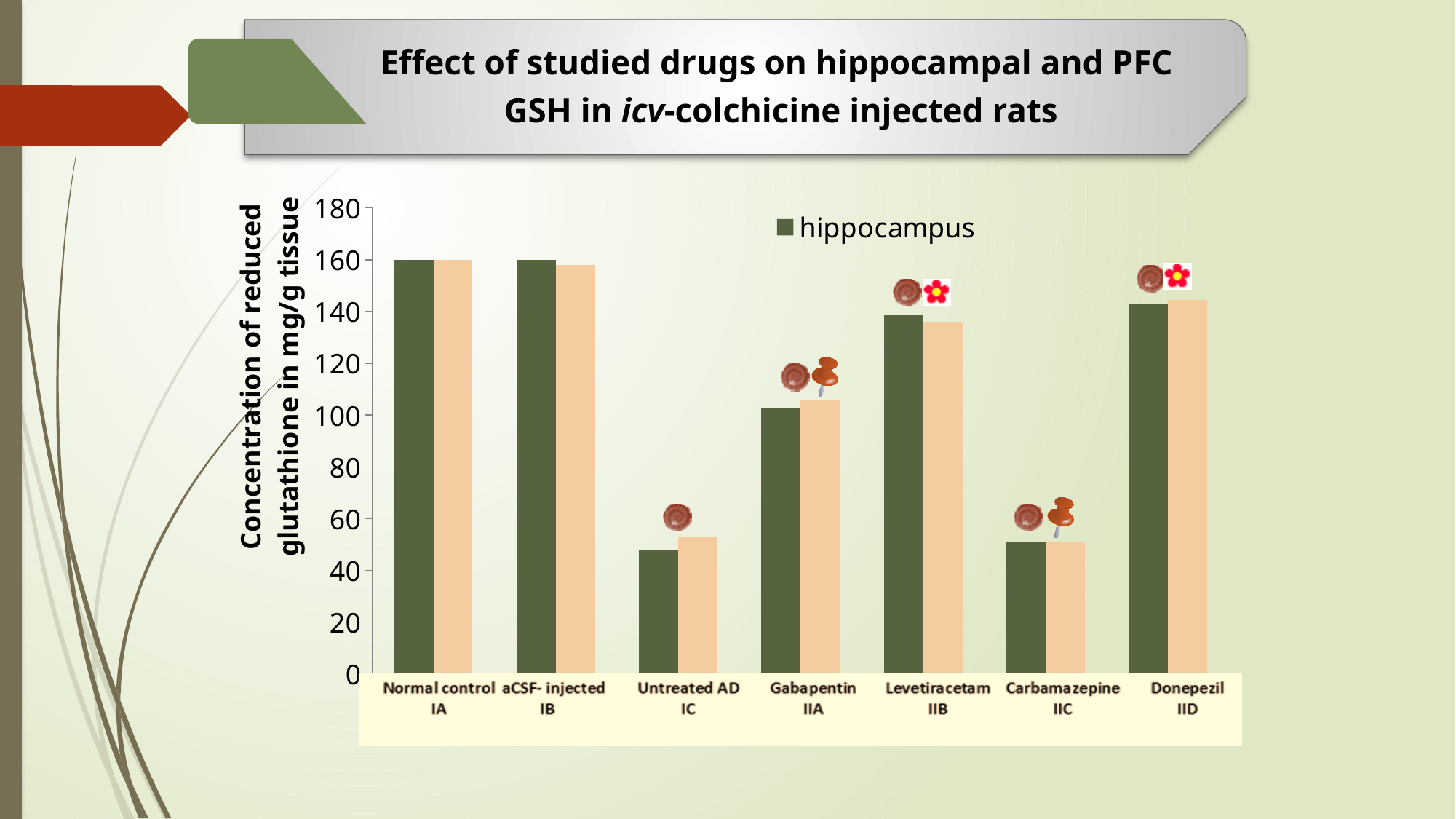
Which has the larger hippocampus value, Levetiracetam IIB or Gabapentin IIA? Levetiracetam IIB Is the hippocampus value for Donepezil IID greater or less than 120? greater What is the label of the y axis? Concentration of reduced glutathione in mg/g tissue Which has the larger hippocampus value, Donepezil IID or Carbamazepine IIC? Donepezil IID Is the hippocampus value for Untreated AD IC greater or less than 60? less Is the hippocampus value for Gabapentin IIA greater or less than 120? less How many categories (treatment groups) are shown on the x axis? 7 What kind of chart is shown on the slide? bar chart What series name is shown in the chart legend? hippocampus Which category has the lowest hippocampus value? Untreated AD IC